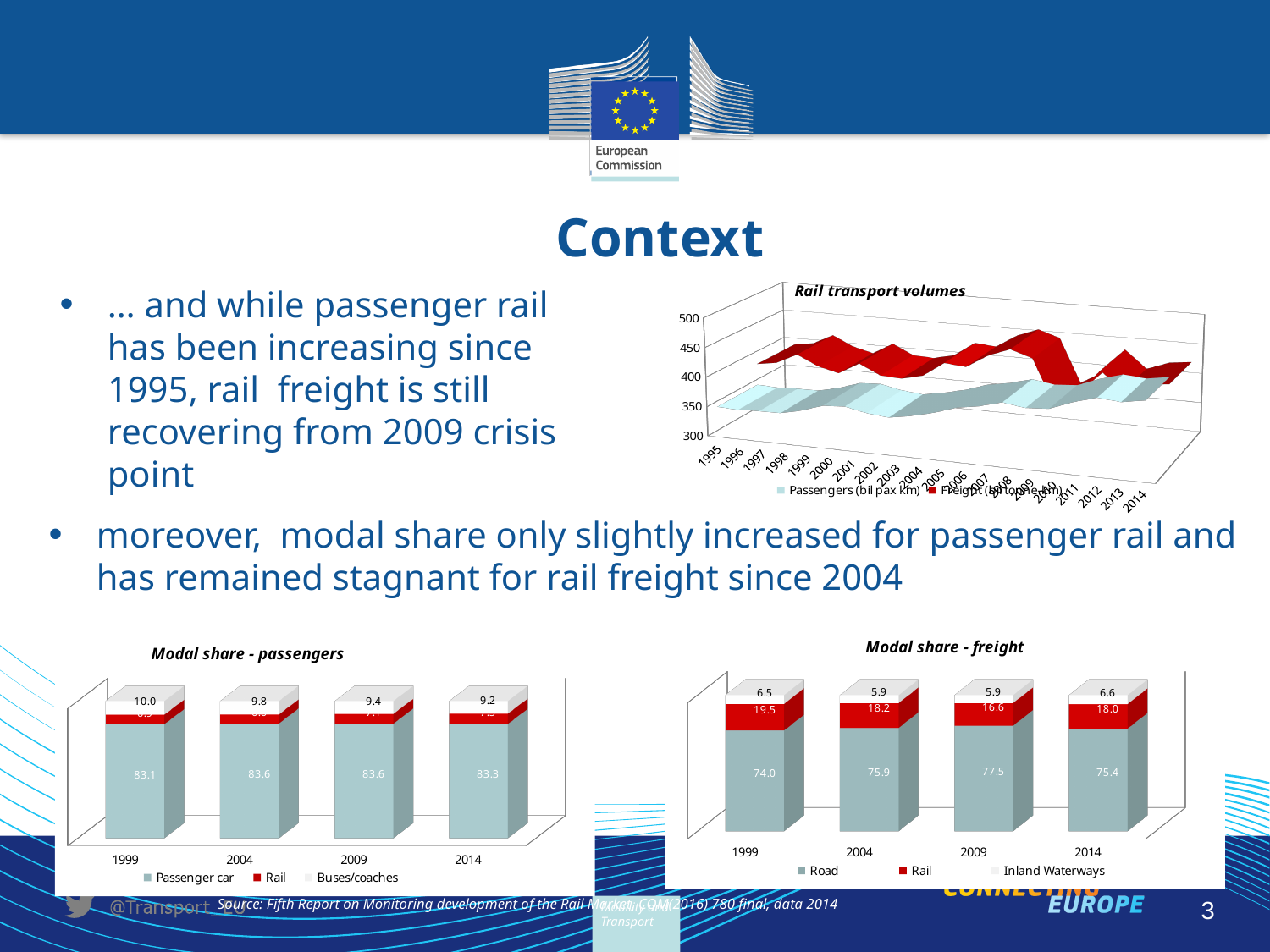
In the Modal share - freight chart, what is the value for Road in 2009? 77.5 In the Modal share - passengers chart, what is the value for Passenger car in 1999? 83.1 In the Rail transport volumes chart, how many series does the legend list? 2 In the Modal share - passengers chart, how many years are shown on the x axis? 4 In the Modal share - freight chart, what is the value for Inland Waterways in 2014? 6.6 In the Modal share - freight chart, which year has the lowest Rail share? 2009 In the Modal share - passengers chart, do the Buses/coaches values rise or fall from 1999 to 2014? fall In the Modal share - freight chart, which year has the highest Road share? 2009 In the Modal share - freight chart, what is the value for Rail in 1999? 19.5 In the Modal share - freight chart, what is the difference between the Rail share in 1999 and in 2009? 2.9 In the Modal share - freight chart, how many series does the legend list? 3 In the Modal share - passengers chart, what is the value for Buses/coaches in 2014? 9.2